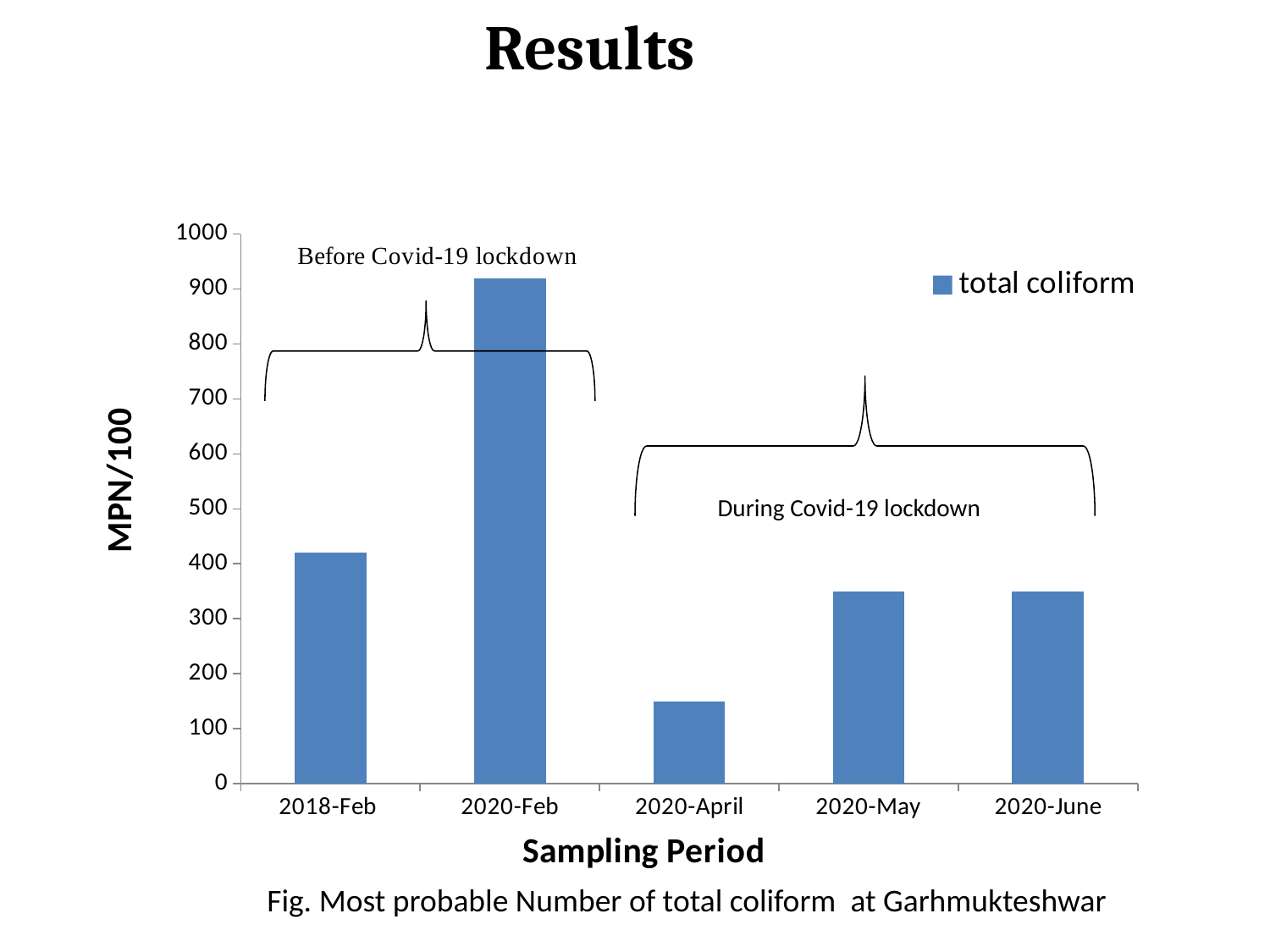
Which has a larger total coliform value, 2018-Feb or 2020-April? 2018-Feb Is the total coliform value for 2020-May greater or less than 400? less Is the total coliform value for 2020-Feb greater or less than 800? greater Which has a larger total coliform value, 2020-Feb or 2020-June? 2020-Feb Which sampling period has the lowest total coliform value? 2020-April Is the total coliform value for 2020-April greater or less than 200? less What is the label of the y axis? MPN/100 How many series does the legend list? 1 What kind of chart is shown on the slide? bar chart Which sampling period has the highest total coliform value? 2020-Feb How many sampling periods are shown on the x axis? 5